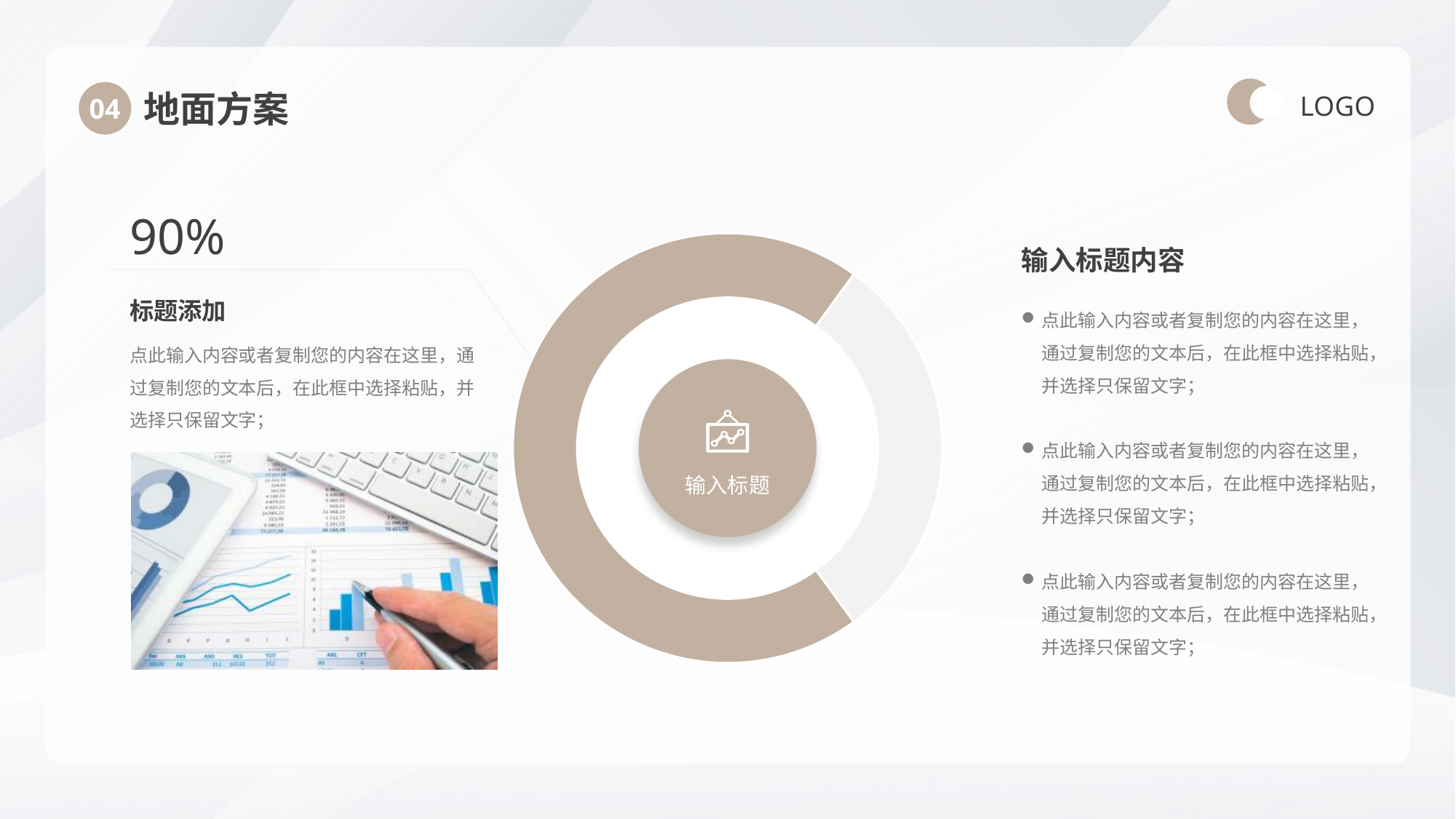
What text is written in the circle at the centre of the doughnut chart? 输入标题 Is the tan segment of the doughnut chart more or less than half of the ring? More Which segment of the doughnut chart is larger, the tan one or the light grey one? The tan one How many segments does the doughnut chart have? 2 What kind of chart is shown in the centre of the slide? Doughnut chart What two colours are used for the segments of the doughnut chart? Tan and light grey Which segment of the doughnut chart is the smallest? The light grey segment